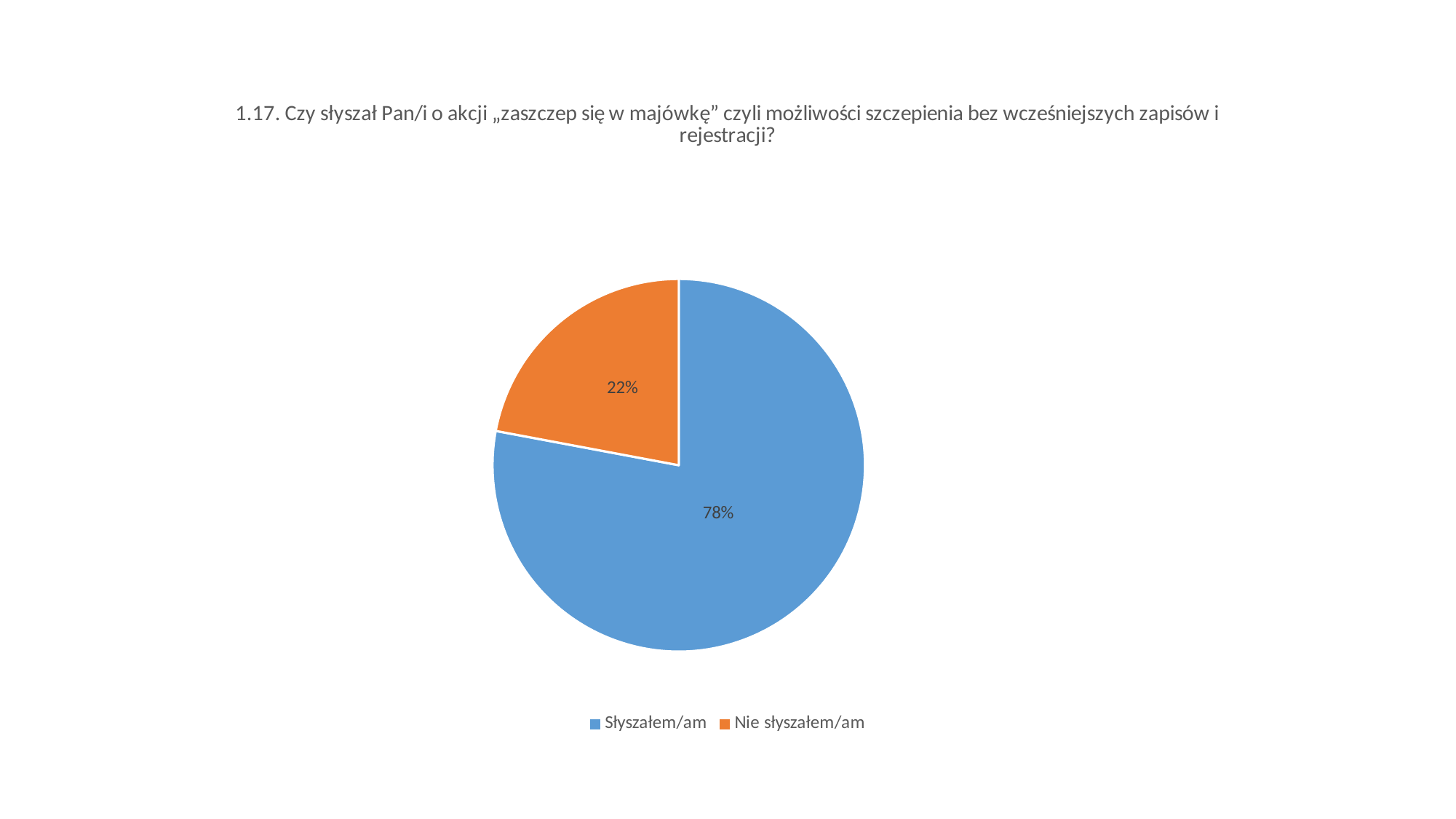
What colour is the "Nie słyszałem/am" slice? orange Which is larger, the "Słyszałem/am" slice or the "Nie słyszałem/am" slice? Słyszałem/am What share of the pie is labelled "Słyszałem/am"? 78% Which category has the smallest slice of the pie? Nie słyszałem/am How many slices does the pie chart have? 2 What colour is the "Słyszałem/am" slice? blue What kind of chart is shown on the slide? pie chart How many entries does the legend list? 2 What is the difference in percentage points between the "Słyszałem/am" and "Nie słyszałem/am" slices? 56 Which category has the largest slice of the pie? Słyszałem/am What share of the pie is labelled "Nie słyszałem/am"? 22%